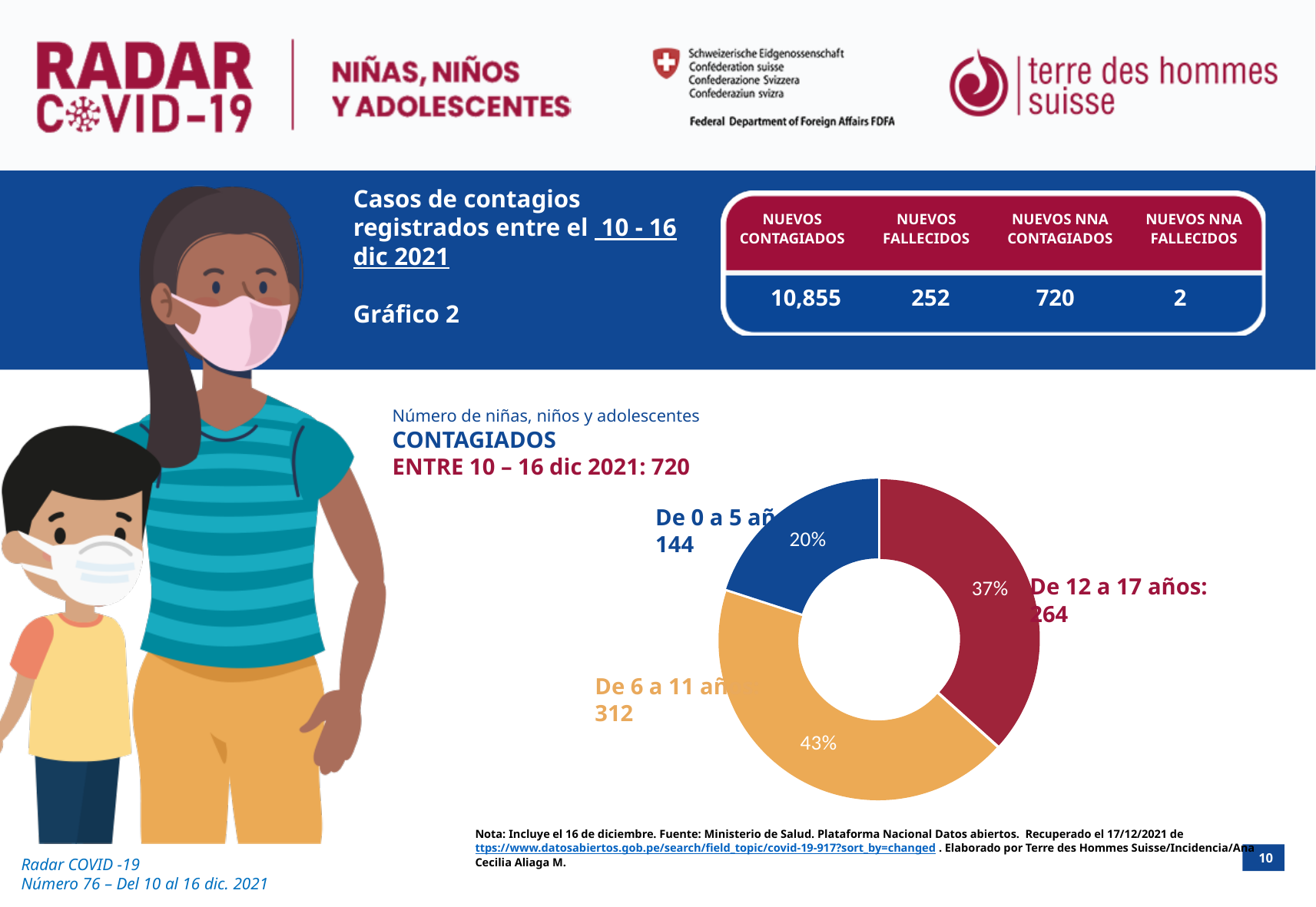
What is the number of contagiados for the group De 0 a 5 años? 144 What kind of chart is shown on the slide? Donut (pie) chart What is the number of contagiados for the group De 6 a 11 años? 312 How many age groups does the donut chart show? 3 Which age group has the highest number of contagiados? De 6 a 11 años Which group has more contagiados, De 12 a 17 años or De 0 a 5 años? De 12 a 17 años Which age group has the lowest number of contagiados? De 0 a 5 años What is the total number of niñas, niños y adolescentes contagiados shown for 10 – 16 dic 2021? 720 What is the difference in contagiados between De 6 a 11 años and De 12 a 17 años? 48 What is the number of contagiados for the group De 12 a 17 años? 264 What percentage of the donut chart corresponds to De 0 a 5 años? 20% What percentage of the donut chart corresponds to De 6 a 11 años? 43%